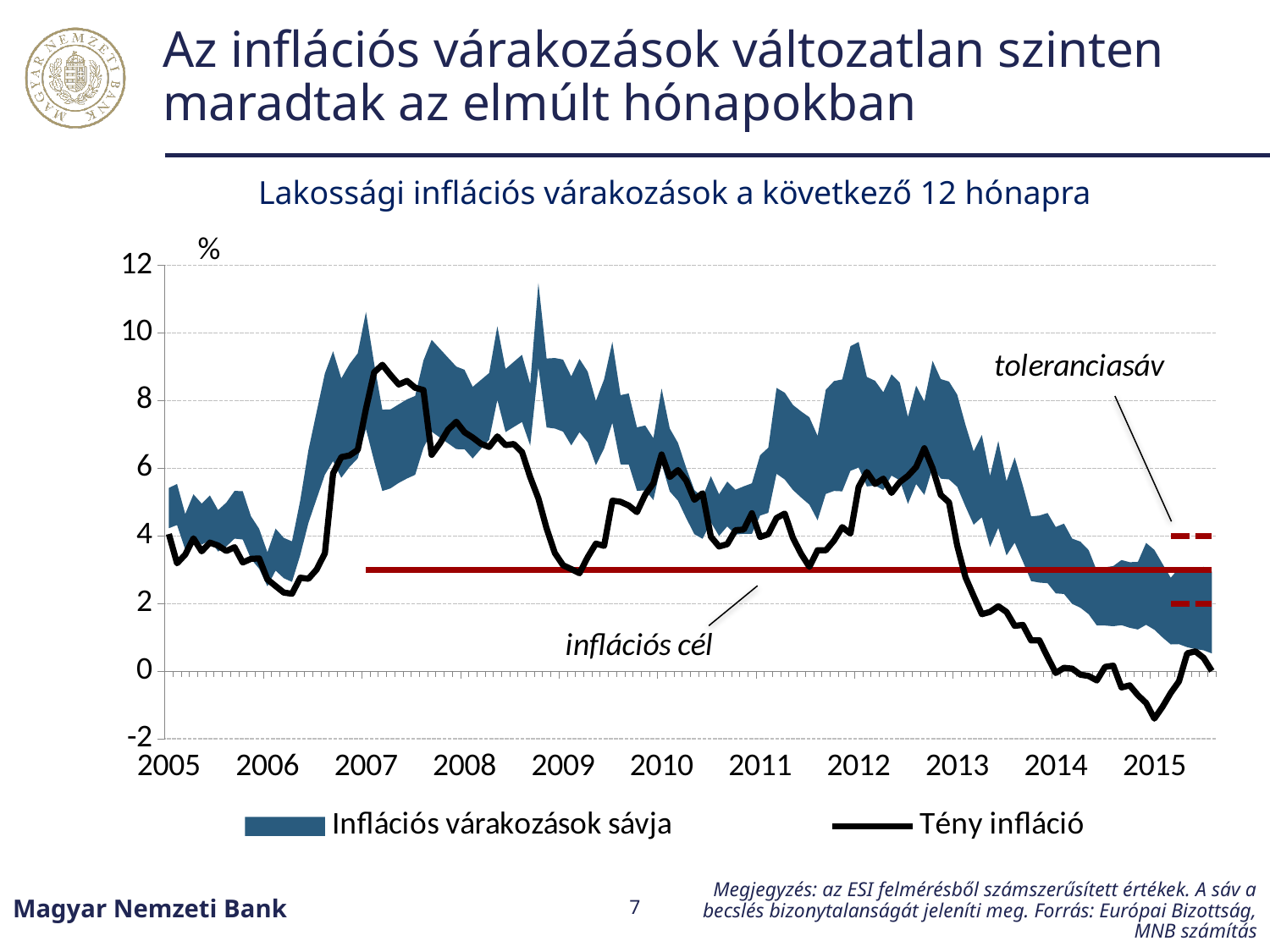
Is the inflációs cél line greater or less than 4? less What is the title of the chart? Lakossági inflációs várakozások a következő 12 hónapra What unit is shown on the y axis of the chart? % What kind of chart is shown on the slide? combination area and line chart Is the value of Tény infláció at its 2007 peak greater or less than 8? greater Is the value of Tény infláció at the start of 2014 greater or less than 2? less Does Tény infláció rise or fall between 2013 and 2014? fall How many year labels are shown on the x axis? 11 Which is higher, Tény infláció at the start of 2007 or at the start of 2014? start of 2007 How many series does the chart legend list? 2 Does Tény infláció rise or fall between 2006 and 2007? rise